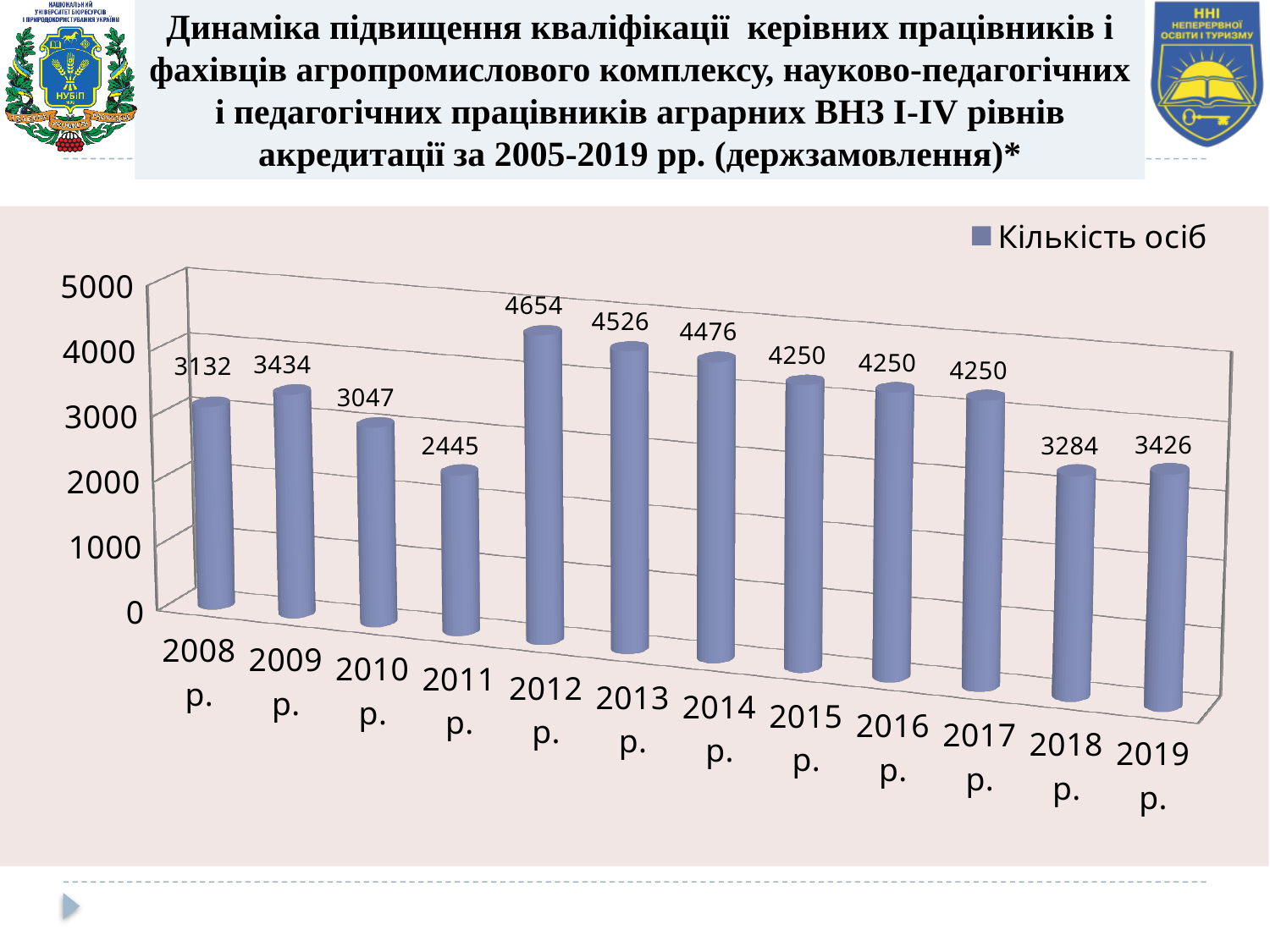
What is the value for 2012 р.? 4654 Which year has the lowest value? 2011 р. Which is larger, the value for 2009 р. or the value for 2018 р.? 2009 р. How many series does the legend list? 1 How many years are shown on the x axis? 12 What is the legend entry for the series? Кількість осіб What is the difference between the values for 2012 р. and 2011 р.? 2209 Is the value for 2013 р. greater or less than 4000? greater Which year has the highest value? 2012 р. What is the value for 2011 р.? 2445 What is the value for 2019 р.? 3426 What kind of chart is shown on the slide? bar chart